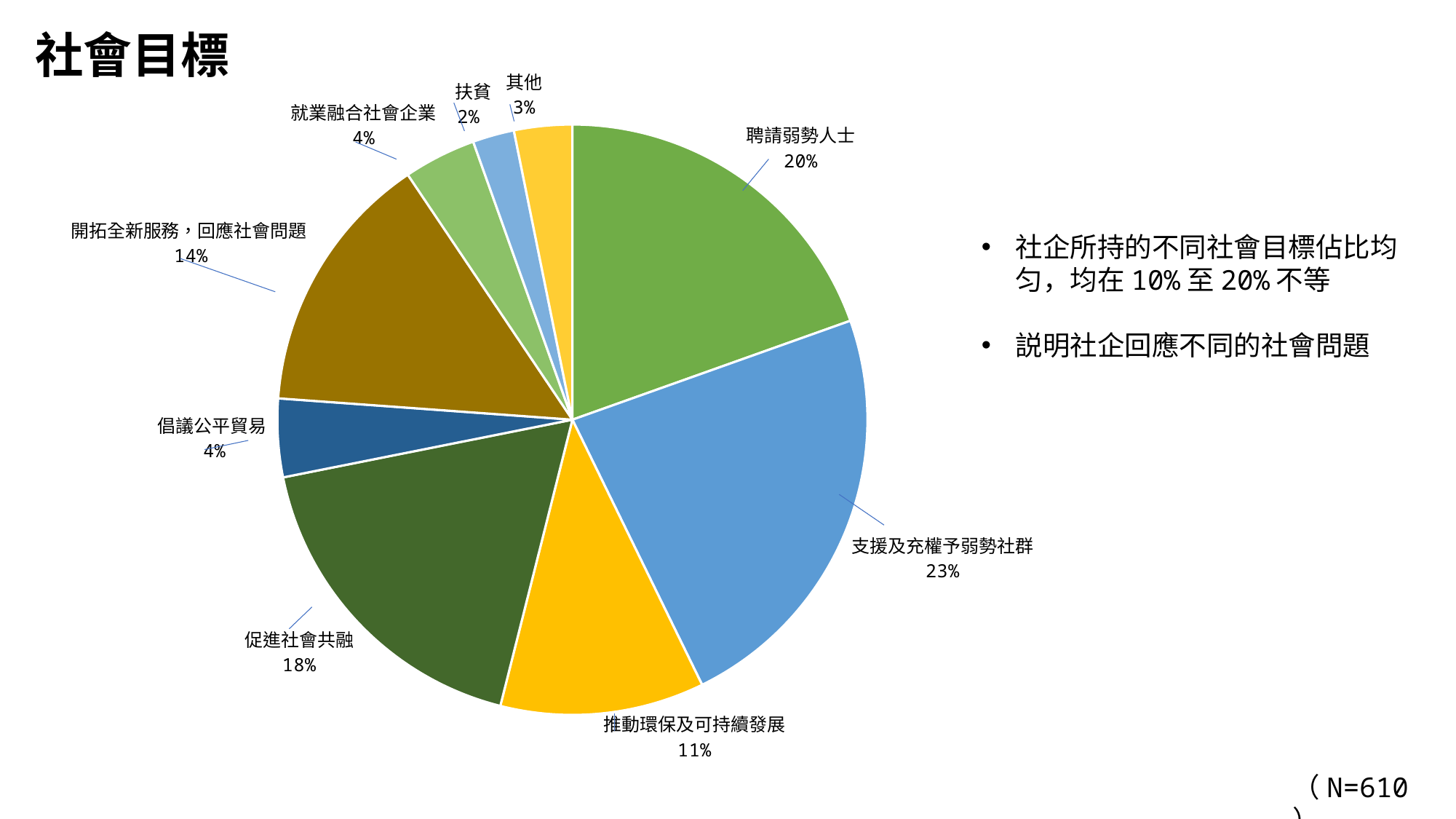
What percentage is shown for 聘請弱勢人士? 20% What percentage is shown for 促進社會共融? 18% Which category has the largest slice of the pie? 支援及充權予弱勢社群 What is the title of the slide containing the chart? 社會目標 What kind of chart is shown on the slide? Pie chart What percentage is shown for 推動環保及可持續發展? 11% What share of the pie does 支援及充權予弱勢社群 represent? 23% What is the difference in percentage points between 支援及充權予弱勢社群 and 聘請弱勢人士? 3 Which is larger, 開拓全新服務，回應社會問題 or 推動環保及可持續發展? 開拓全新服務，回應社會問題 Which category has the smallest slice of the pie? 扶貧 How many categories are shown in the pie chart? 9 What percentage is shown for 其他? 3%